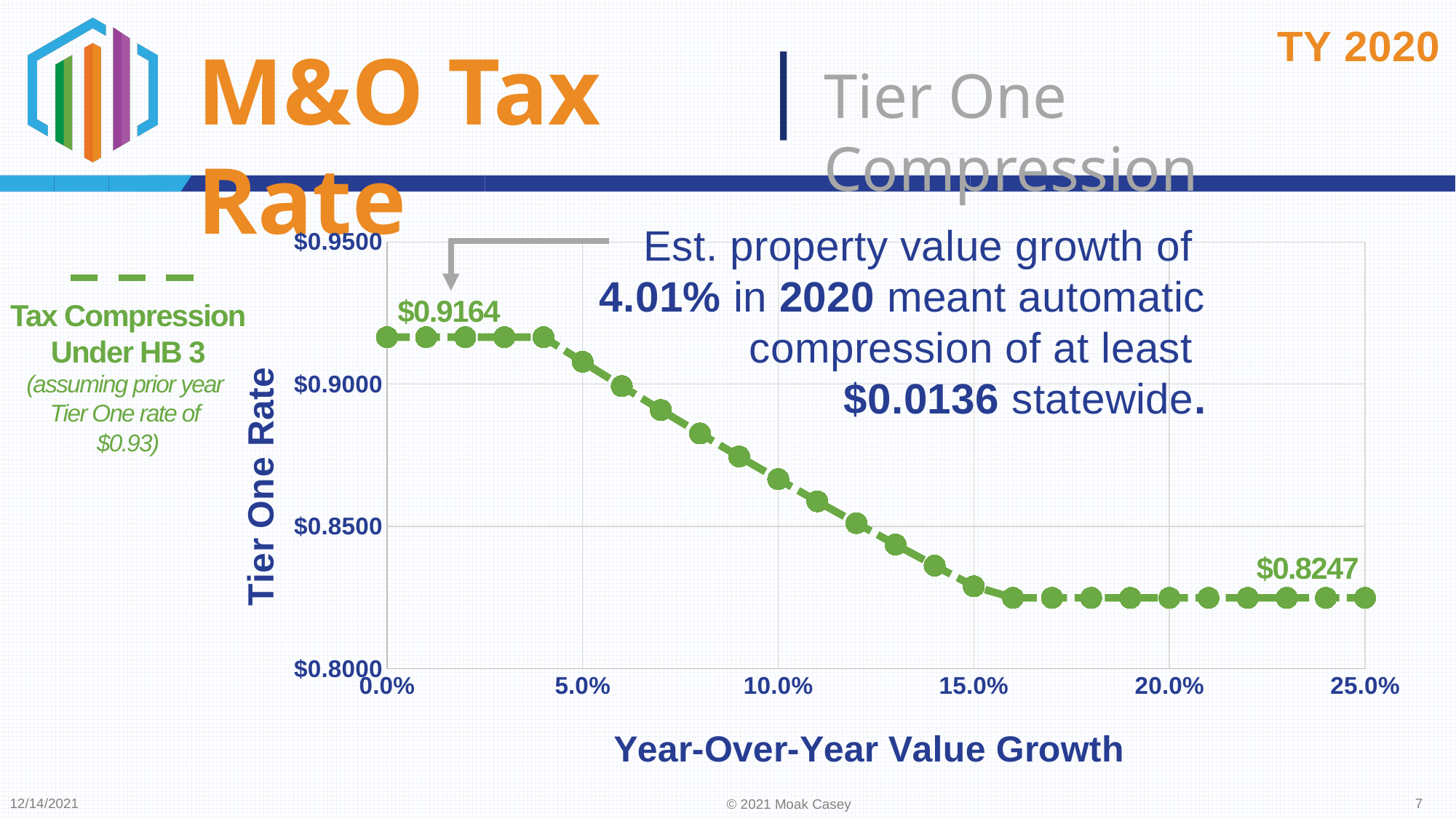
Overall, does the Tier One Rate rise or fall as year-over-year value growth increases along the x axis? fall What is the difference between the Tier One Rate at 0.0% growth and at 25.0% growth? $0.0917 What is the Tier One Rate at 0.0% year-over-year value growth? $0.9164 Is the Tier One Rate at 10.0% value growth greater or less than $0.8500? greater What is the title of the chart's y axis? Tier One Rate Which has the higher Tier One Rate: 0.0% value growth or 25.0% value growth? 0.0% What is the title of the chart's x axis? Year-Over-Year Value Growth What is the Tier One Rate at 25.0% year-over-year value growth? $0.8247 Is the Tier One Rate at 20.0% value growth greater or less than $0.8500? less Is the Tier One Rate at 8.0% value growth greater or less than $0.9000? less What kind of chart is shown on the slide? line chart